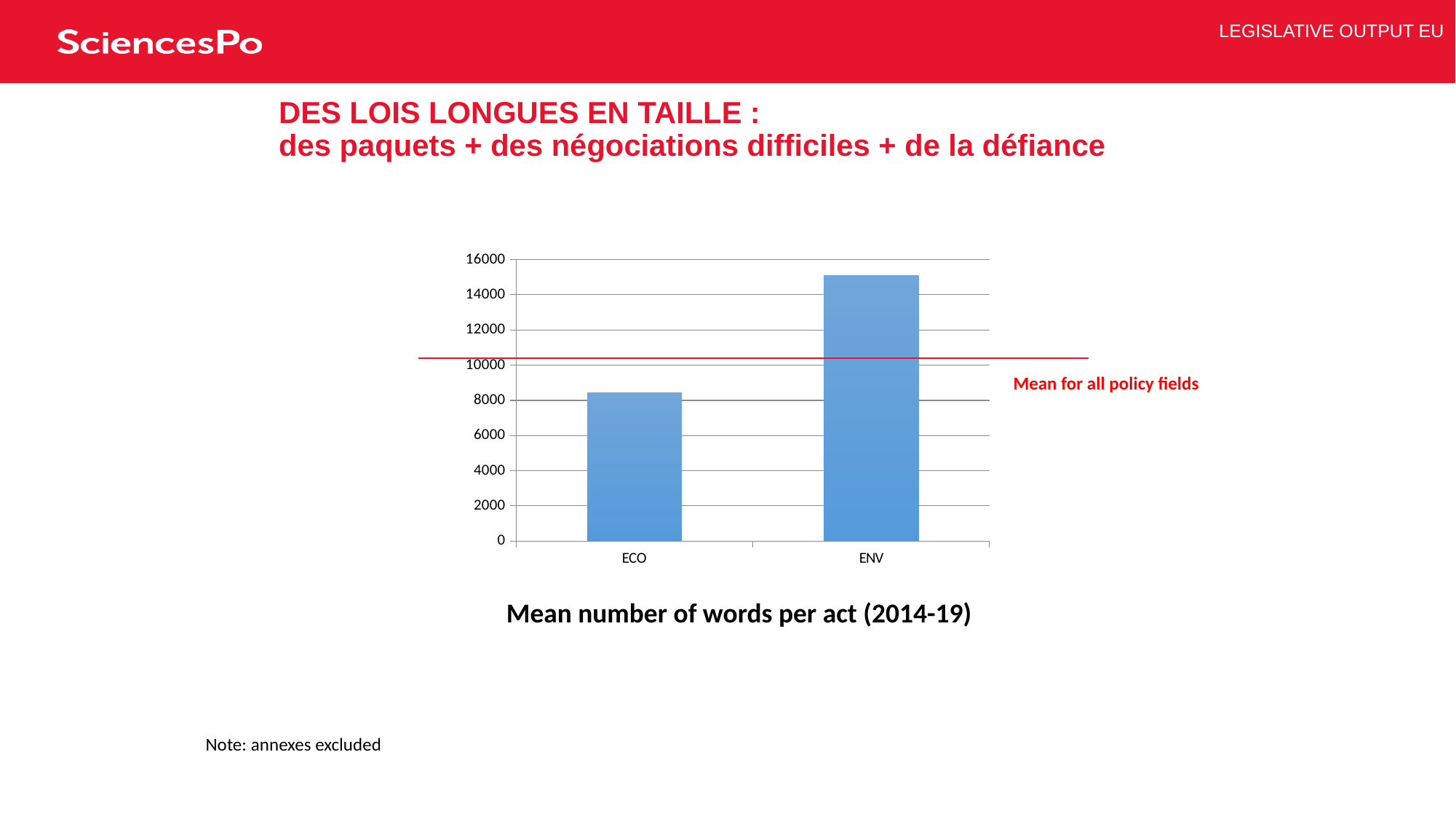
What kind of chart is shown on the slide? bar chart What does the red horizontal line on the chart represent? Mean for all policy fields Is the value for ECO greater or less than 10000? less What is the caption below the chart? Mean number of words per act (2014-19) Is the value for ENV greater or less than 14000? greater Which category has the highest mean number of words per act? ENV How many categories are plotted on the x axis of the chart? 2 Which category has the lowest mean number of words per act? ECO Is the value for ENV greater or less than 16000? less What is the highest value shown on the y axis of the chart? 16000 Which is larger, the value for ECO or the value for ENV? ENV